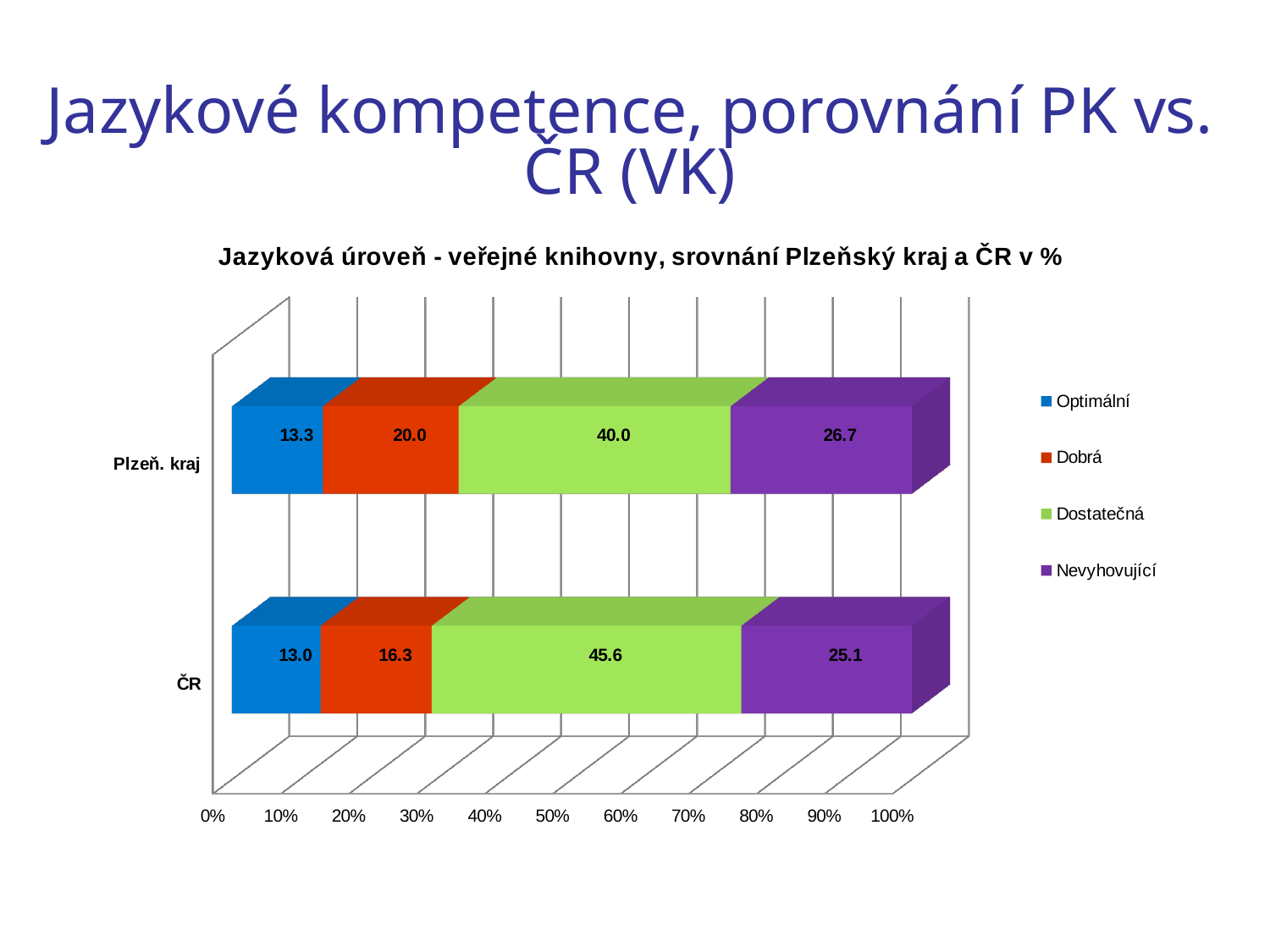
What kind of chart is shown? Stacked bar chart What is the value for Optimální for ČR? 13.0 How many categories are shown on the y axis? 2 What is the value for Dostatečná for Plzeň. kraj? 40.0 What is the value for Nevyhovující for ČR? 25.1 Which series has the highest value for ČR? Dostatečná What is the value for Dobrá for Plzeň. kraj? 20.0 What is the title of the chart? Jazyková úroveň - veřejné knihovny, srovnání Plzeňský kraj a ČR v % What is the difference between the Dostatečná values for ČR and Plzeň. kraj? 5.6 Which series has the lowest value for Plzeň. kraj? Optimální How many series does the legend list? 4 Which is larger, the Dobrá value for Plzeň. kraj or for ČR? Plzeň. kraj